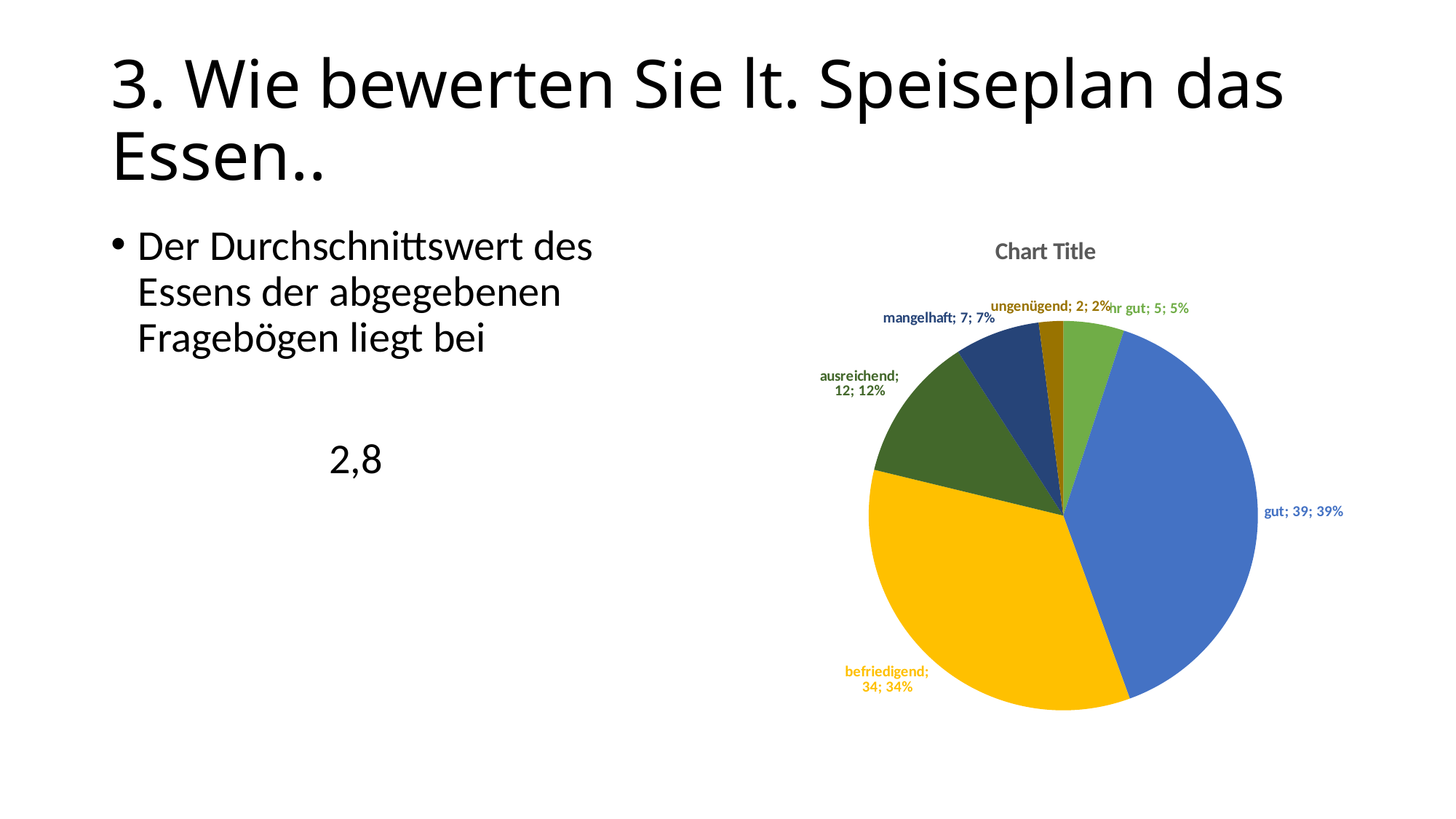
How many slices does the pie chart have? 6 What kind of chart is shown on the slide? pie chart What percentage share does the "ungenügend" slice have? 2% What is the title shown above the pie chart? Chart Title What is the difference between the values for "gut" and "befriedigend"? 5 What is the value for the "mangelhaft" slice? 7 What is the value for the "gut" slice? 39 Which category has the smallest slice of the pie? ungenügend Which is larger, the value for "ausreichend" or the value for "mangelhaft"? ausreichend What percentage share does the "befriedigend" slice have? 34% Which category has the largest slice of the pie? gut What is the value for the "ausreichend" slice? 12